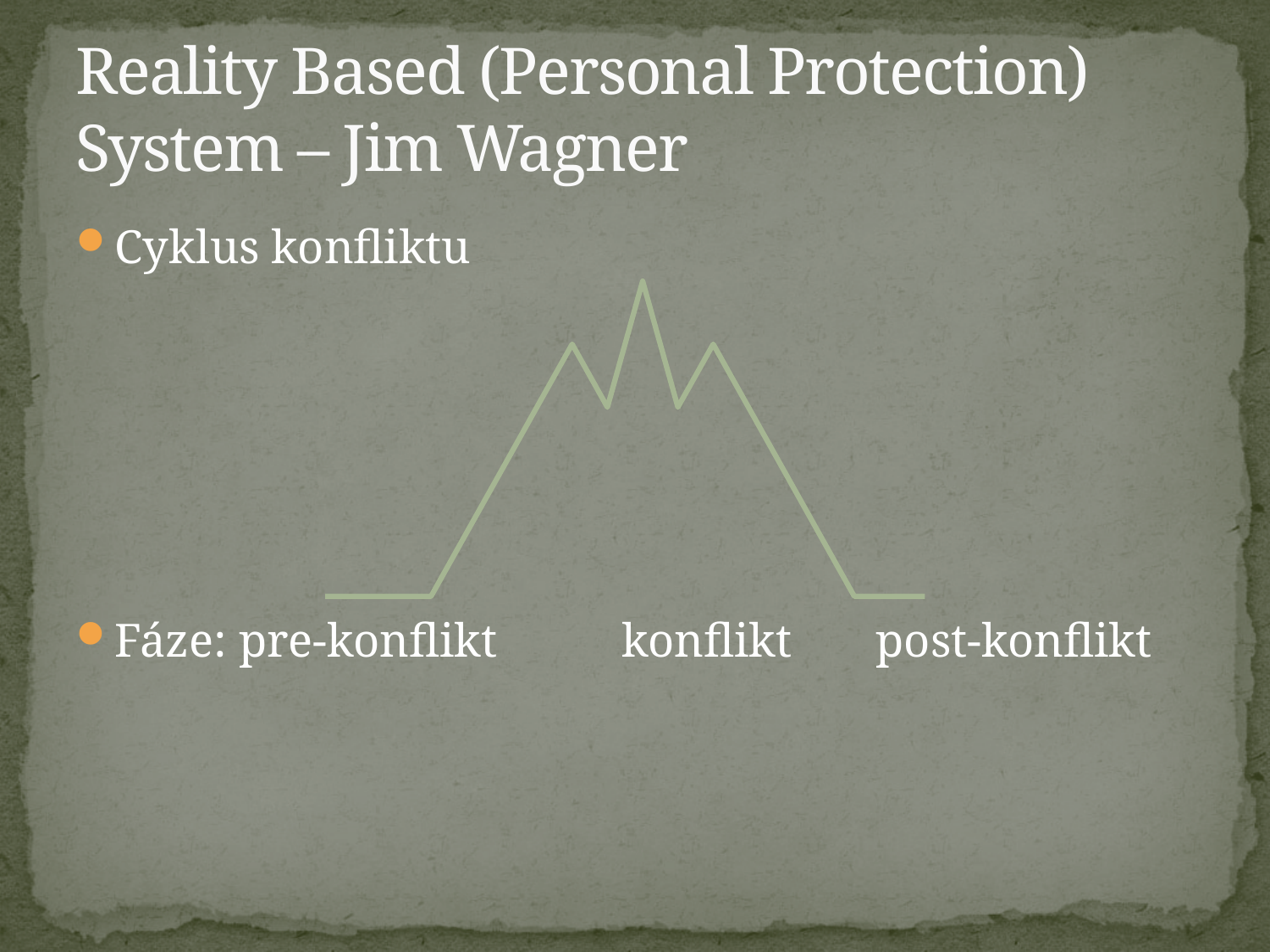
Does the line in the conflict cycle chart rise or fall between the 'pre-konflikt' phase and the 'konflikt' phase? rise What is the label of the first phase shown on the conflict cycle chart? pre-konflikt What is the label of the last phase shown on the conflict cycle chart? post-konflikt Does the line in the conflict cycle chart rise or fall between the 'konflikt' phase and the 'post-konflikt' phase? fall In which labelled phase does the line of the conflict cycle chart reach its highest point? konflikt Which of the three peaks in the conflict cycle chart is the tallest: the first, the second or the third? the second How many phases are labelled along the bottom of the conflict cycle chart? 3 What kind of chart is shown on the slide under 'Cyklus konfliktu'? line chart How many peaks does the line in the conflict cycle chart have? 3